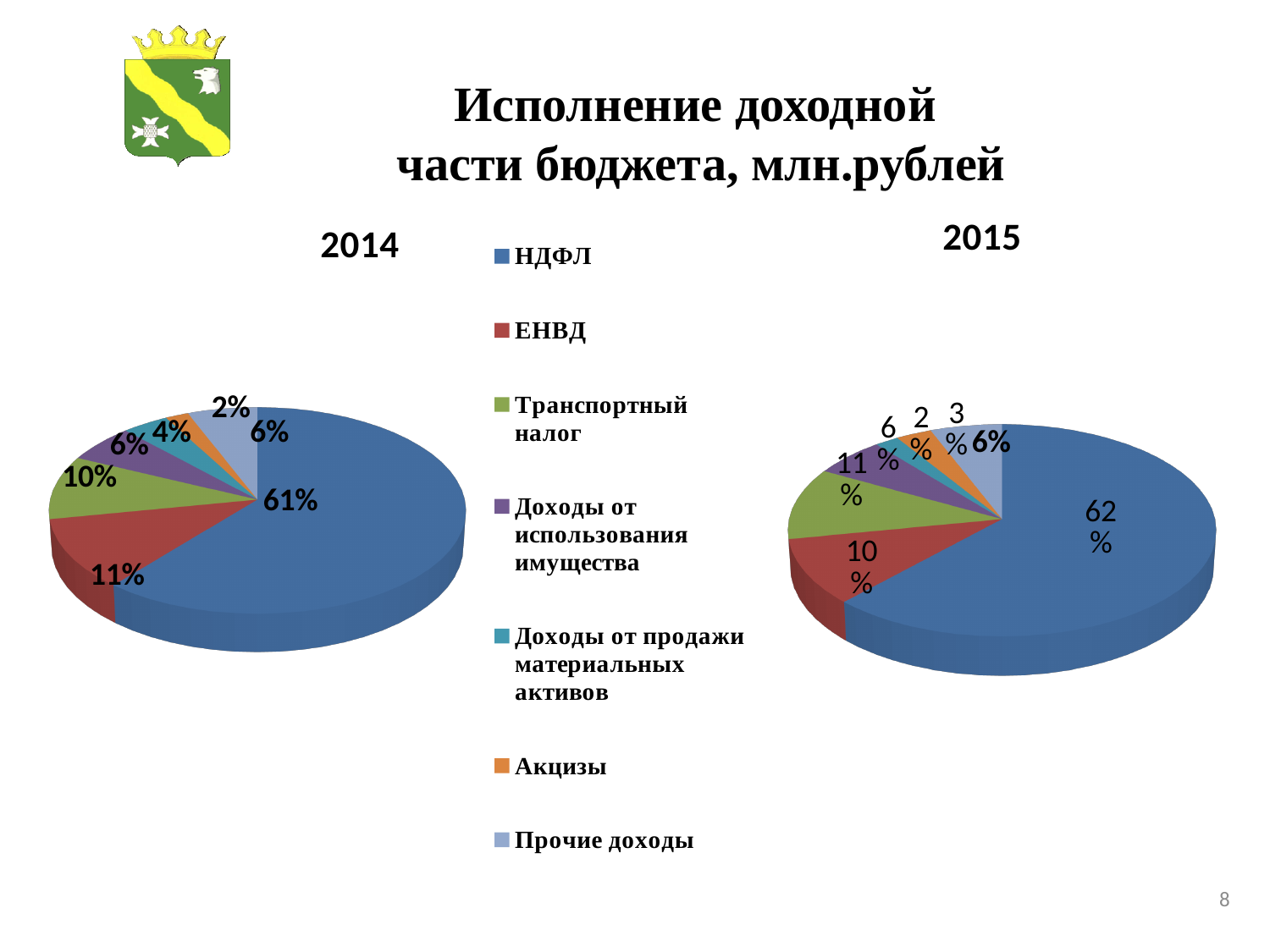
In the 2014 pie chart, which is larger: the share of ЕНВД or the share of Транспортный налог? ЕНВД In the 2015 pie chart, which category has the smallest share? Доходы от продажи материальных активов What type of chart is used for the 2014 data? Pie chart In the 2015 pie chart, what share does Доходы от продажи материальных активов have? 2% How many categories does the legend list? 7 In the 2014 pie chart, what share does НДФЛ have? 61% In the 2015 pie chart, what share does НДФЛ have? 62% In the 2015 pie chart, what share does Транспортный налог have? 11% In the 2014 pie chart, what share does Акцизы have? 2% What is the difference between the НДФЛ share in 2015 and in 2014? 1% In the 2014 pie chart, which category has the largest share? НДФЛ In the 2014 pie chart, what share does ЕНВД have? 11%